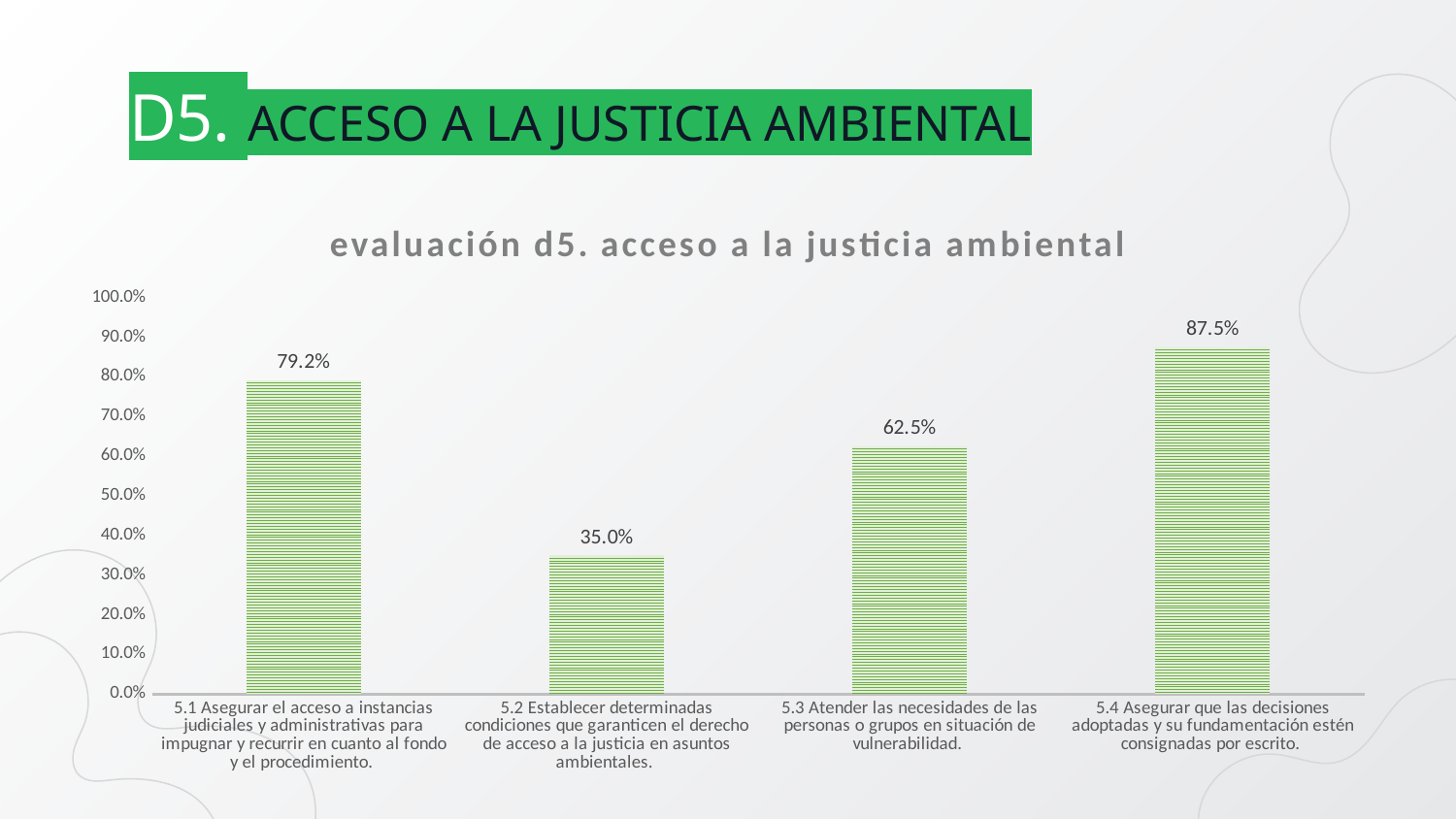
What is the difference between the values for 5.4 and 5.2? 52.5% Which category has the highest value? 5.4 Asegurar que las decisiones adoptadas y su fundamentación estén consignadas por escrito. What is the value for 5.3 Atender las necesidades de las personas o grupos en situación de vulnerabilidad? 62.5% Is the value for 5.3 greater or less than 50.0%? greater What kind of chart is shown on the slide? Bar chart What is the value for 5.2 Establecer determinadas condiciones que garanticen el derecho de acceso a la justicia en asuntos ambientales? 35.0% What is the value for 5.4 Asegurar que las decisiones adoptadas y su fundamentación estén consignadas por escrito? 87.5% Which is larger, the value for 5.1 or the value for 5.3? 5.1 How many categories are shown in the chart? 4 What is the difference between the values for 5.1 and 5.3? 16.7% What is the value for 5.1 Asegurar el acceso a instancias judiciales y administrativas para impugnar y recurrir en cuanto al fondo y el procedimiento? 79.2% Which category has the lowest value? 5.2 Establecer determinadas condiciones que garanticen el derecho de acceso a la justicia en asuntos ambientales.